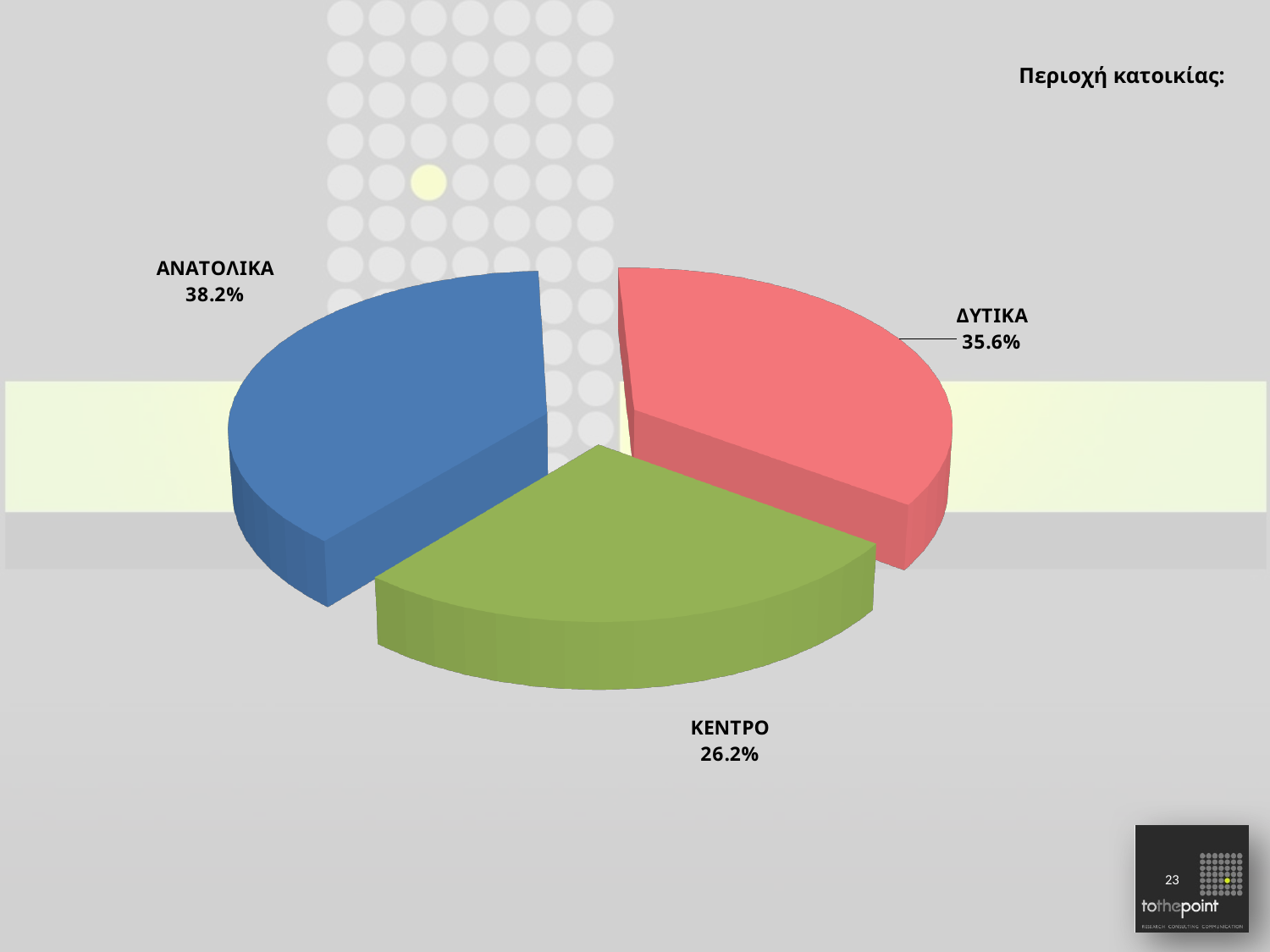
Which category has the largest share of the pie? ΑΝΑΤΟΛΙΚΑ Which is larger, the share for ΔΥΤΙΚΑ or the share for ΚΕΝΤΡΟ? ΔΥΤΙΚΑ What percentage is shown for ΑΝΑΤΟΛΙΚΑ? 38.2% Which category has the smallest share of the pie? ΚΕΝΤΡΟ What is the difference in percentage points between ΑΝΑΤΟΛΙΚΑ and ΚΕΝΤΡΟ? 12.0% What kind of chart is shown on the slide? pie chart How many slices does the pie chart have? 3 What percentage is shown for ΔΥΤΙΚΑ? 35.6% What colour is the ΚΕΝΤΡΟ slice? green What is the title shown above the pie chart? Περιοχή κατοικίας: What is the difference in percentage points between ΔΥΤΙΚΑ and ΚΕΝΤΡΟ? 9.4% What percentage is shown for ΚΕΝΤΡΟ? 26.2%